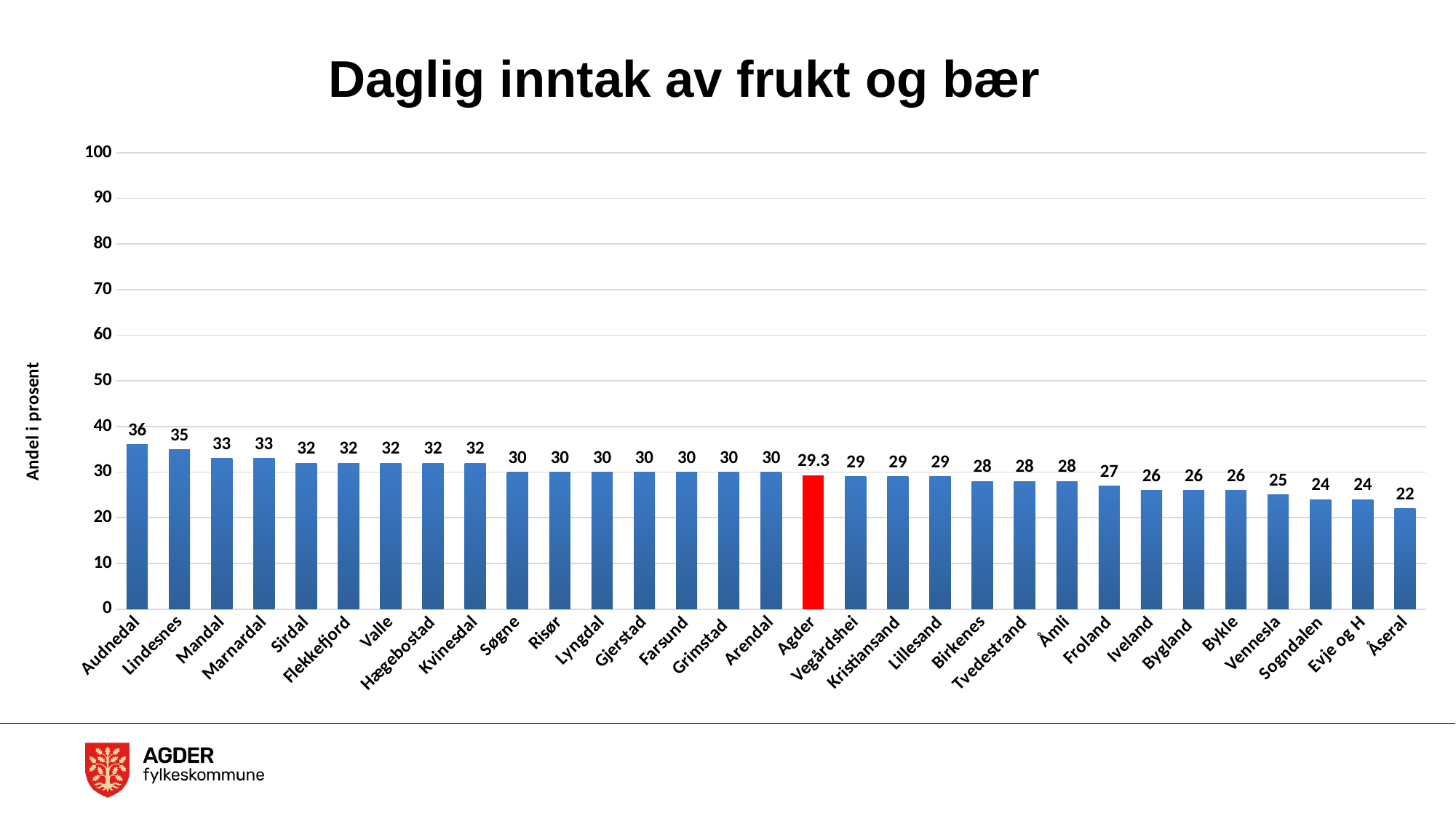
Is the value for Froland greater or less than 30? less Which category has the lowest value? Åseral Which has a larger value, Lindesnes or Vennesla? Lindesnes Which category has the highest value? Audnedal Do the values rise or fall from left to right along the x axis? fall What is the value for Kristiansand? 29 How many categories are shown on the x axis? 31 What kind of chart is this? bar chart What is the difference between the values for Audnedal and Åseral? 14 What is the value for Agder, the red bar? 29.3 What is the title of the chart? Daglig inntak av frukt og bær What is the value for Audnedal? 36